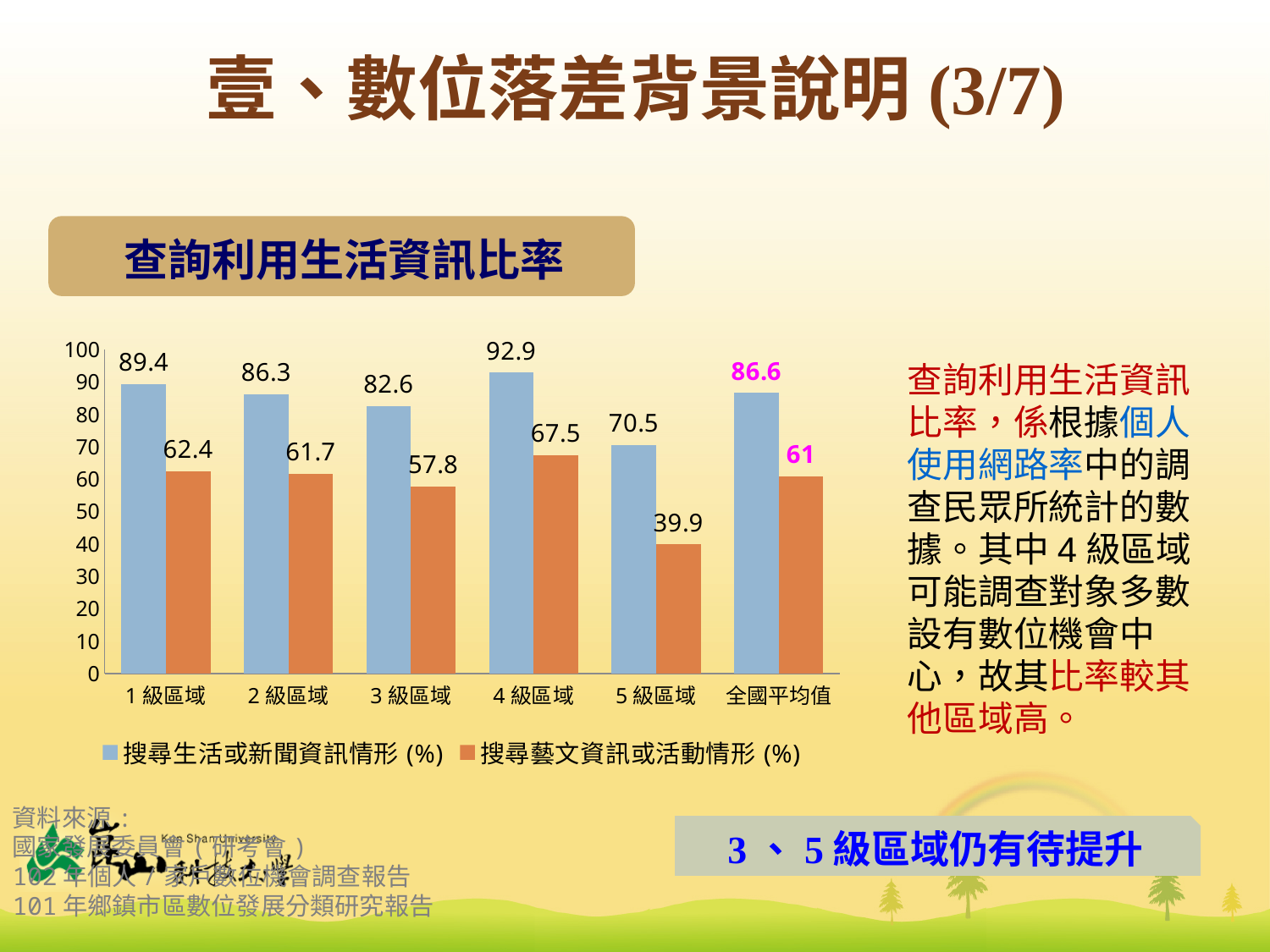
What is the value of 搜尋藝文資訊或活動情形 (%) for 5 級區域? 39.9 Which category has the highest value for 搜尋生活或新聞資訊情形 (%)? 4 級區域 Which is larger: 搜尋生活或新聞資訊情形 (%) for 2 級區域 or for 3 級區域? 2 級區域 What is the value of 搜尋生活或新聞資訊情形 (%) for 4 級區域? 92.9 How many series does the legend list? 2 How many categories are shown on the x axis? 6 What is the value of 搜尋藝文資訊或活動情形 (%) for 全國平均值? 61 What is the difference between 搜尋生活或新聞資訊情形 (%) and 搜尋藝文資訊或活動情形 (%) for 1 級區域? 27 Is the value of 搜尋生活或新聞資訊情形 (%) for 5 級區域 greater or less than 80? less Which category has the lowest value for 搜尋藝文資訊或活動情形 (%)? 5 級區域 What type of chart is shown on the slide? bar chart What is the title shown above the chart? 查詢利用生活資訊比率